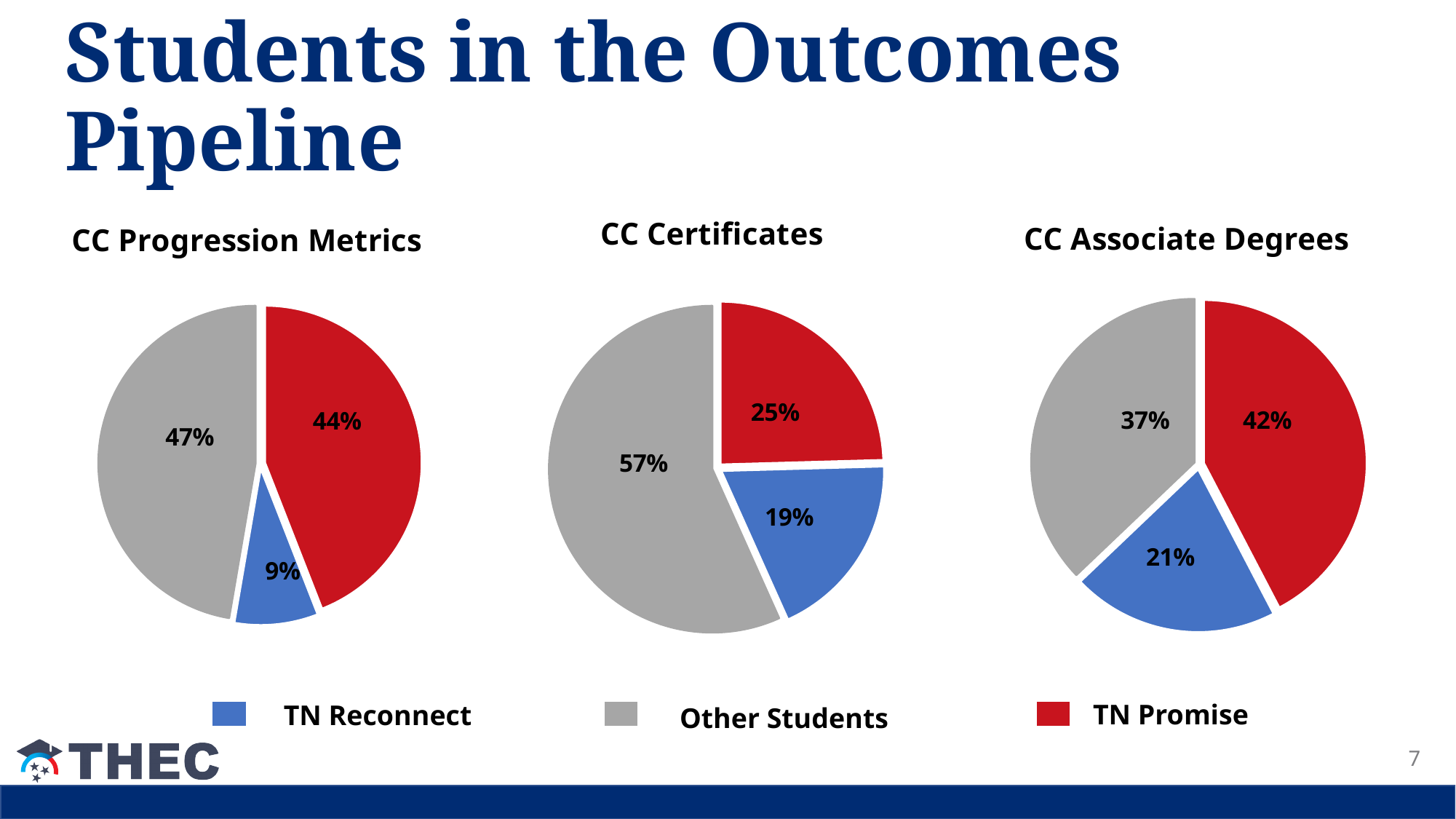
In the CC Associate Degrees chart, what is the difference between the TN Promise share and the TN Reconnect share? 21% In the CC Associate Degrees chart, what share of students is Other Students? 37% Which colour represents TN Reconnect in the legend? Blue In the CC Certificates chart, what share of students is TN Reconnect? 19% In the CC Certificates chart, what is the difference between the Other Students share and the TN Promise share? 32% How many slices does the CC Certificates pie chart have? 3 In the CC Associate Degrees chart, which group has the largest slice? TN Promise In the CC Progression Metrics chart, which is larger: the TN Promise share or the TN Reconnect share? TN Promise What type of chart is used for CC Associate Degrees? Pie chart In the CC Certificates chart, which group has the largest slice? Other Students In the CC Progression Metrics chart, which group has the smallest slice? TN Reconnect In the CC Progression Metrics chart, what share of students is TN Promise? 44%